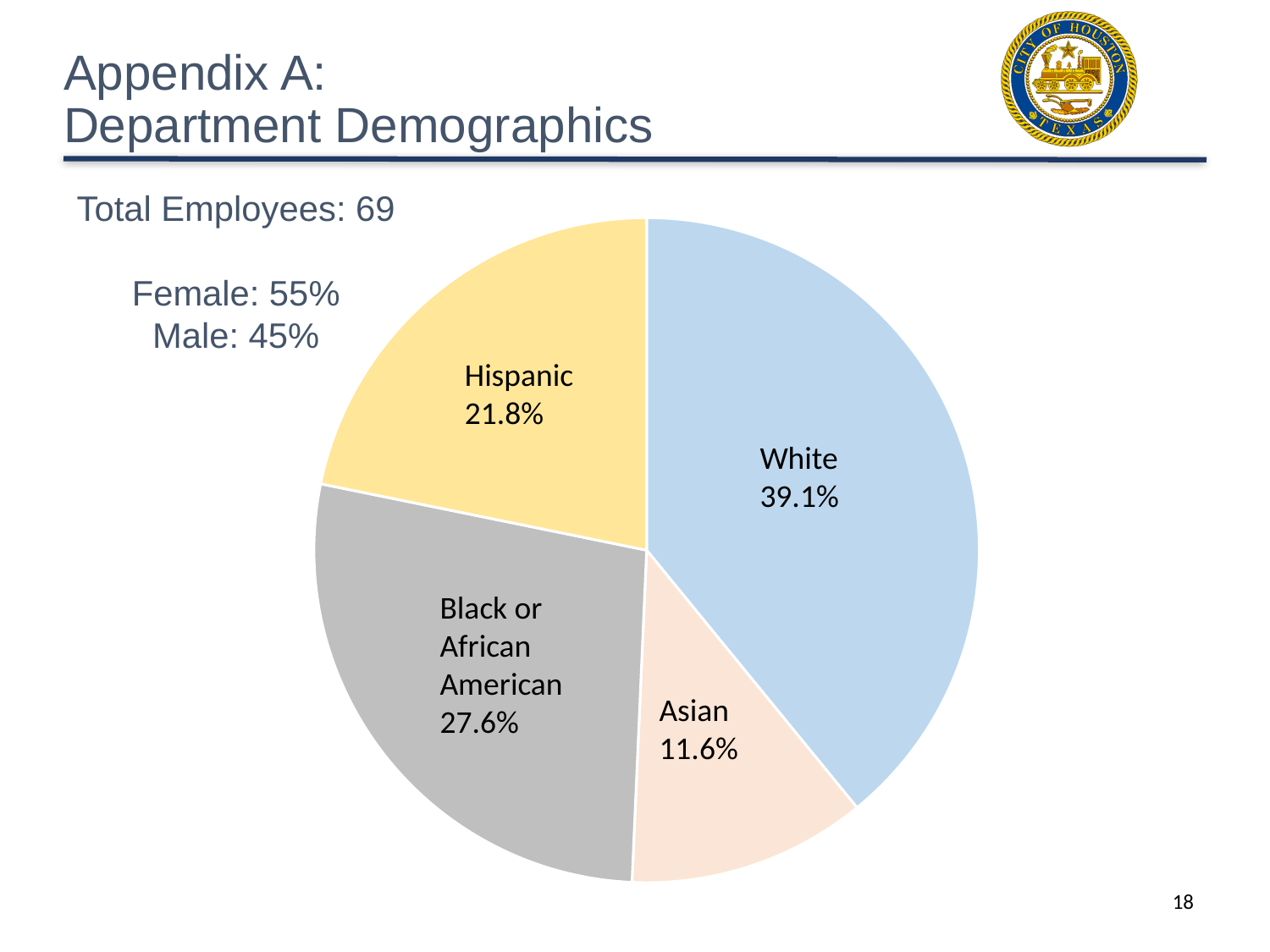
How many slices does the pie chart have? 4 What is the difference in percentage points between the White slice and the Asian slice? 27.5 What percentage of the pie is the Black or African American slice? 27.6% What percentage of the pie is the White slice? 39.1% Which slice of the pie is the smallest? Asian What percentage of the pie is the Hispanic slice? 21.8% Which is larger, the Black or African American slice or the Hispanic slice? Black or African American What colour is the Hispanic slice of the pie? Yellow What kind of chart is shown on the slide? Pie chart What is the difference in percentage points between the Black or African American slice and the Hispanic slice? 5.8 What percentage of the pie is the Asian slice? 11.6% Which slice of the pie is the largest? White